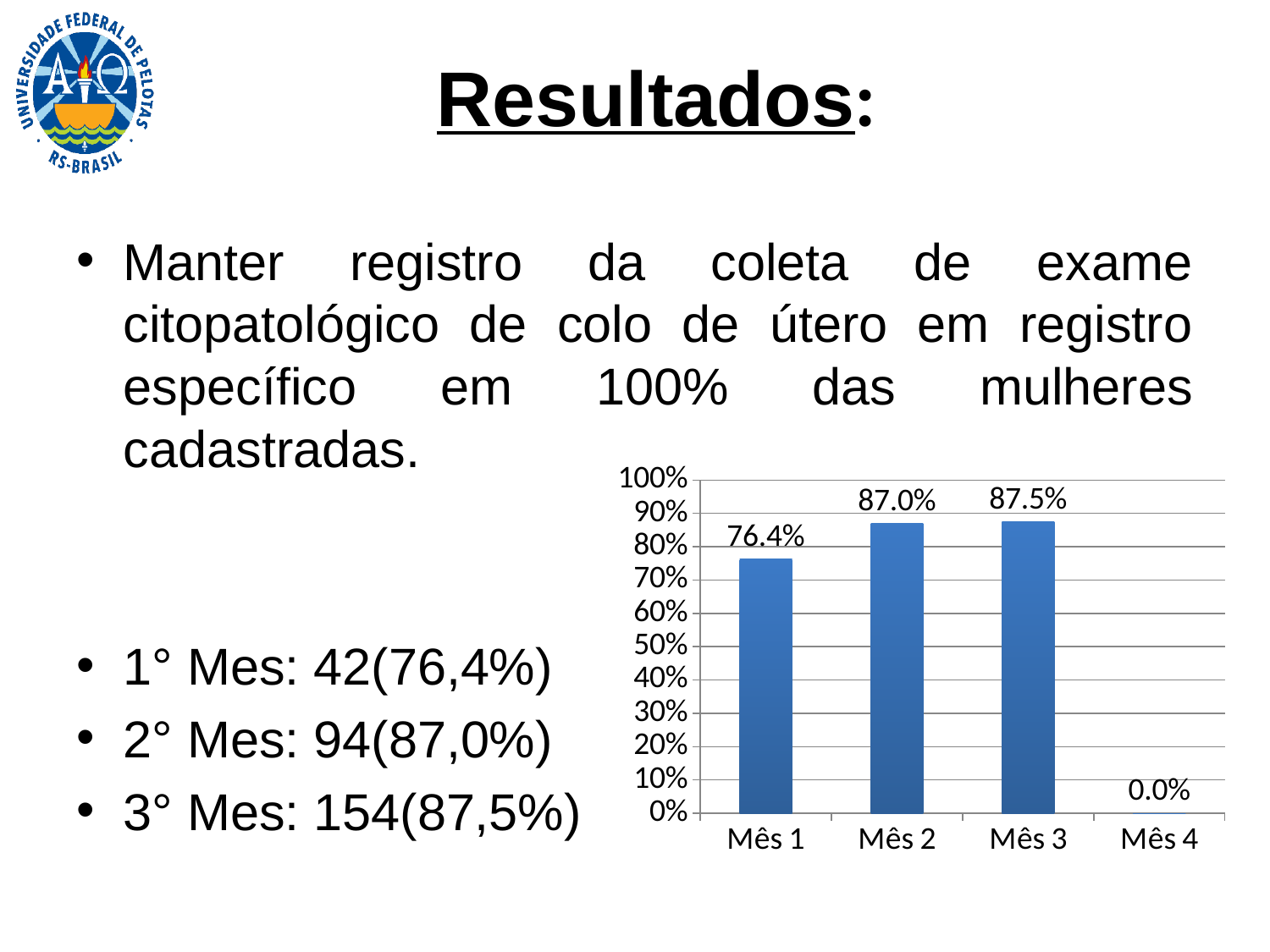
What is the value for Mês 2? 87.0% What is the value for Mês 1? 76.4% What is the value for Mês 3? 87.5% Which is larger, the value for Mês 1 or the value for Mês 2? Mês 2 Which category has the lowest value? Mês 4 What is the value for Mês 4? 0.0% Which category has the highest value? Mês 3 What kind of chart is shown on the slide? bar chart What is the difference between the values for Mês 2 and Mês 1? 10.6% Is the value for Mês 1 greater or less than 80%? less Do the values rise or fall from Mês 1 to Mês 3? rise How many categories are shown on the x axis? 4